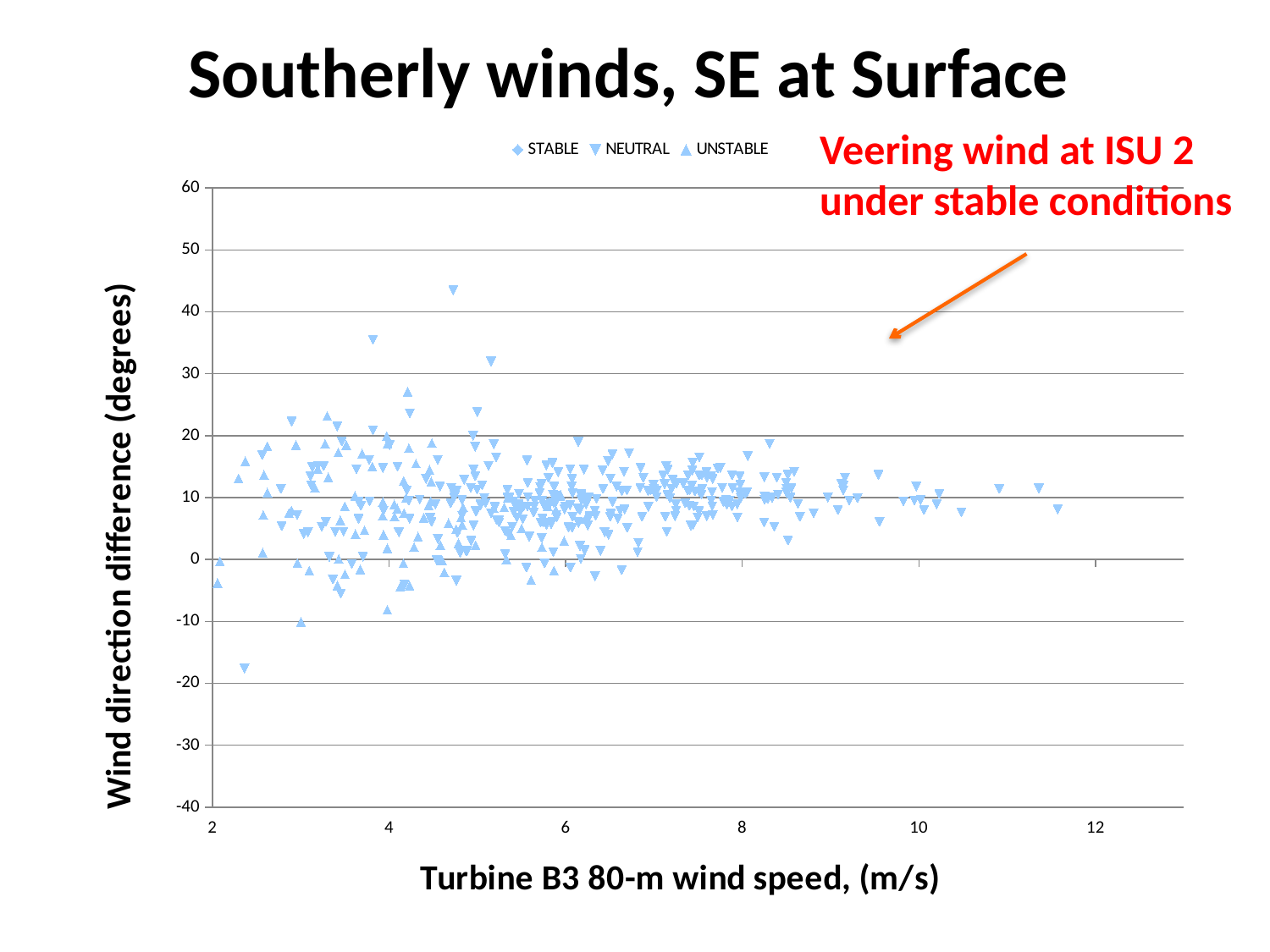
What kind of chart is shown on the slide? scatter chart What are the three series named in the legend? STABLE, NEUTRAL, UNSTABLE Is the highest plotted wind direction difference greater or less than 40? greater How many series does the legend list? 3 Is the lowest plotted wind direction difference greater or less than -20? greater Is the lowest plotted wind direction difference greater or less than -10? less What is the title of the x axis? Turbine B3 80-m wind speed, (m/s)